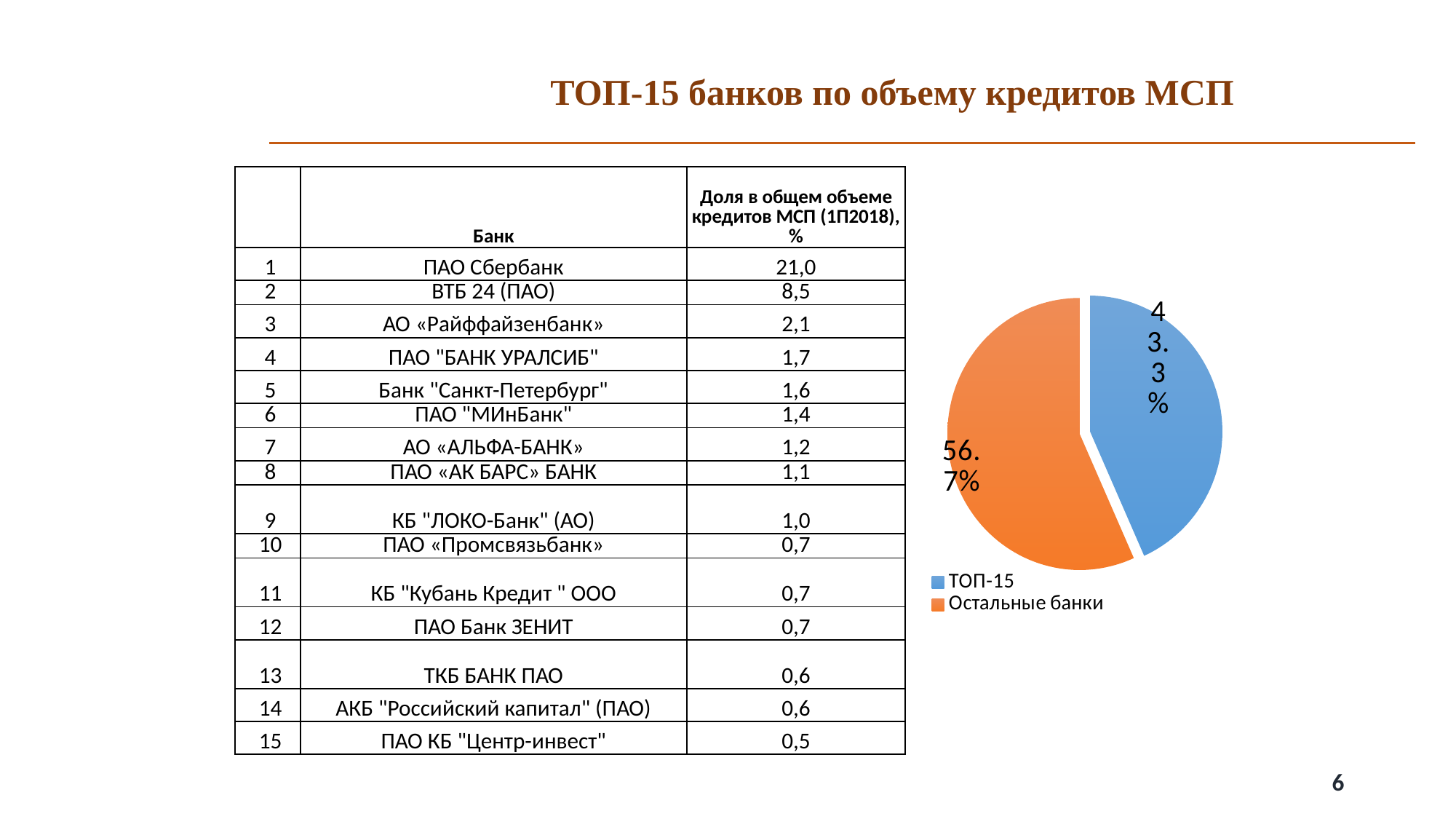
Which slice of the pie chart is the smallest? ТОП-15 In the pie chart, which is larger: ТОП-15 or Остальные банки? Остальные банки Is the share for ТОП-15 in the pie chart greater or less than 50%? less Which slice of the pie chart is the largest? Остальные банки What is the difference between the Остальные банки share and the ТОП-15 share in the pie chart? 13.4% What colour is the ТОП-15 slice in the pie chart? blue What kind of chart is shown on the slide? pie chart How many slices does the pie chart have? 2 What share of the pie chart does Остальные банки have? 56.7% How many entries does the legend of the pie chart list? 2 What colour is the Остальные банки slice in the pie chart? orange What share of the pie chart does ТОП-15 have? 43.3%